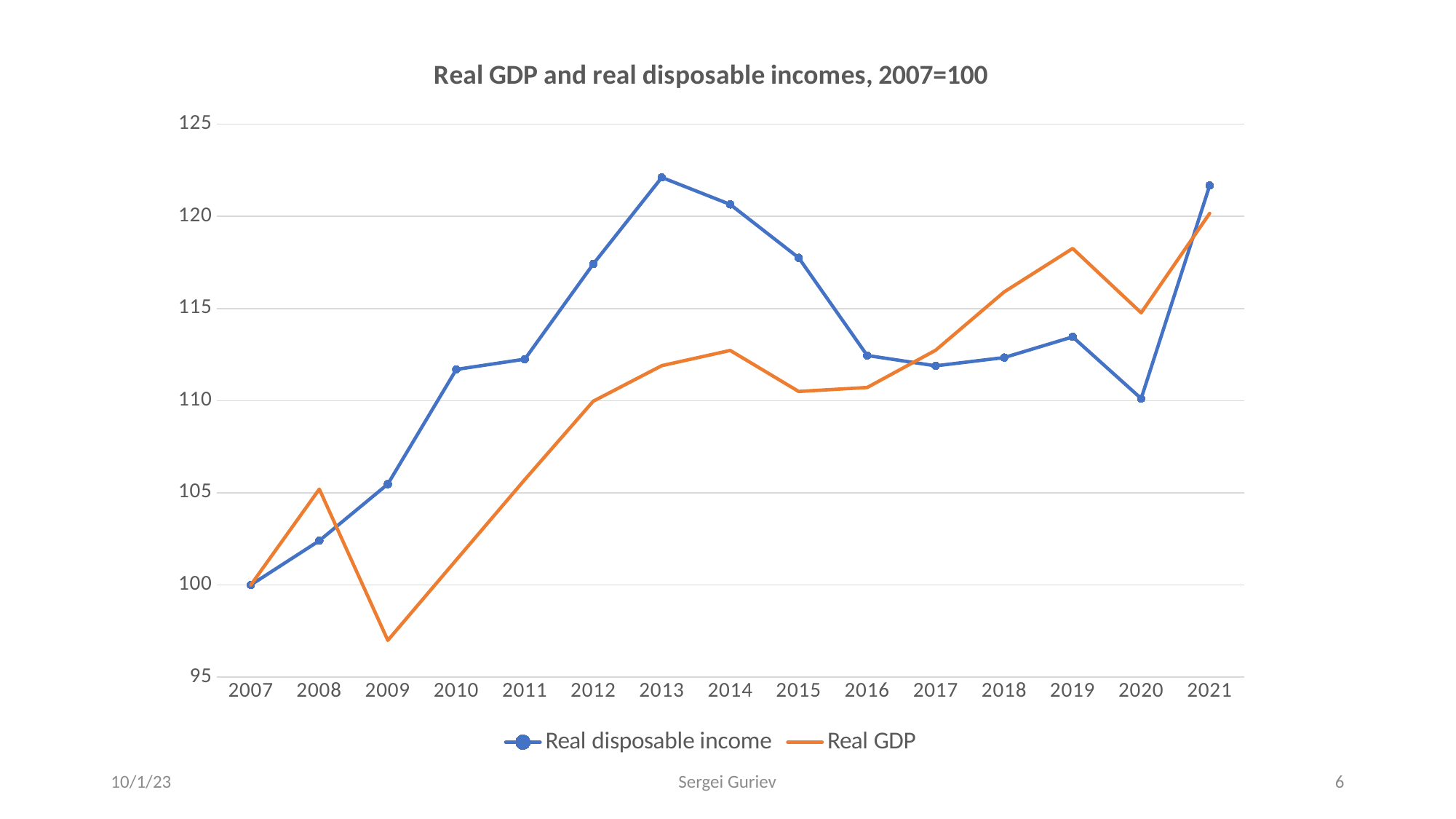
In which year is Real GDP at its highest? 2021 In which year is Real disposable income at its lowest? 2007 In which year is Real GDP at its lowest? 2009 How many years are shown on the x axis? 15 In 2013, which series has the higher value, Real GDP or Real disposable income? Real disposable income In 2019, which series has the higher value, Real GDP or Real disposable income? Real GDP Is the value of Real GDP in 2009 greater or less than 100? less Is the value of Real disposable income in 2013 greater or less than 120? greater What is the value of Real disposable income in 2007? 100 Does Real GDP rise or fall from 2009 to 2014? Rise How many series does the legend list? 2 What kind of chart is shown on the slide? Line chart